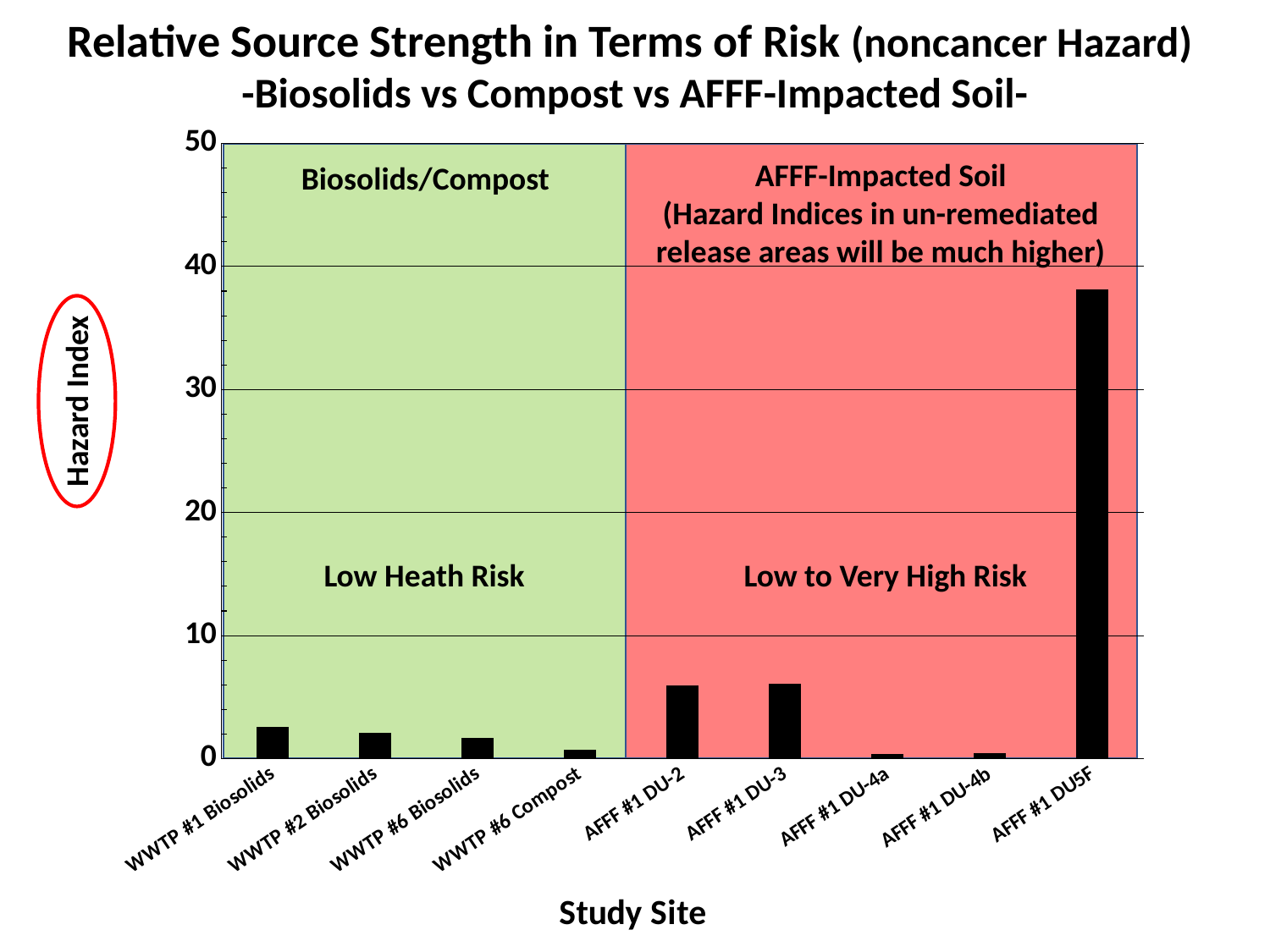
What is the title of the x axis? Study Site Is the Hazard Index for AFFF #1 DU5F greater or less than 40? less Which study site has the highest Hazard Index? AFFF #1 DU5F Is the Hazard Index for WWTP #1 Biosolids greater or less than 10? less Which has a higher Hazard Index, WWTP #1 Biosolids or WWTP #6 Compost? WWTP #1 Biosolids How many study sites are plotted on the x axis? 9 What kind of chart is shown on the slide? bar chart Which has a higher Hazard Index, AFFF #1 DU-3 or AFFF #1 DU-4a? AFFF #1 DU-3 Which has a higher Hazard Index, AFFF #1 DU5F or AFFF #1 DU-2? AFFF #1 DU5F Is the Hazard Index for AFFF #1 DU-2 greater or less than 10? less What is the title of the y axis? Hazard Index